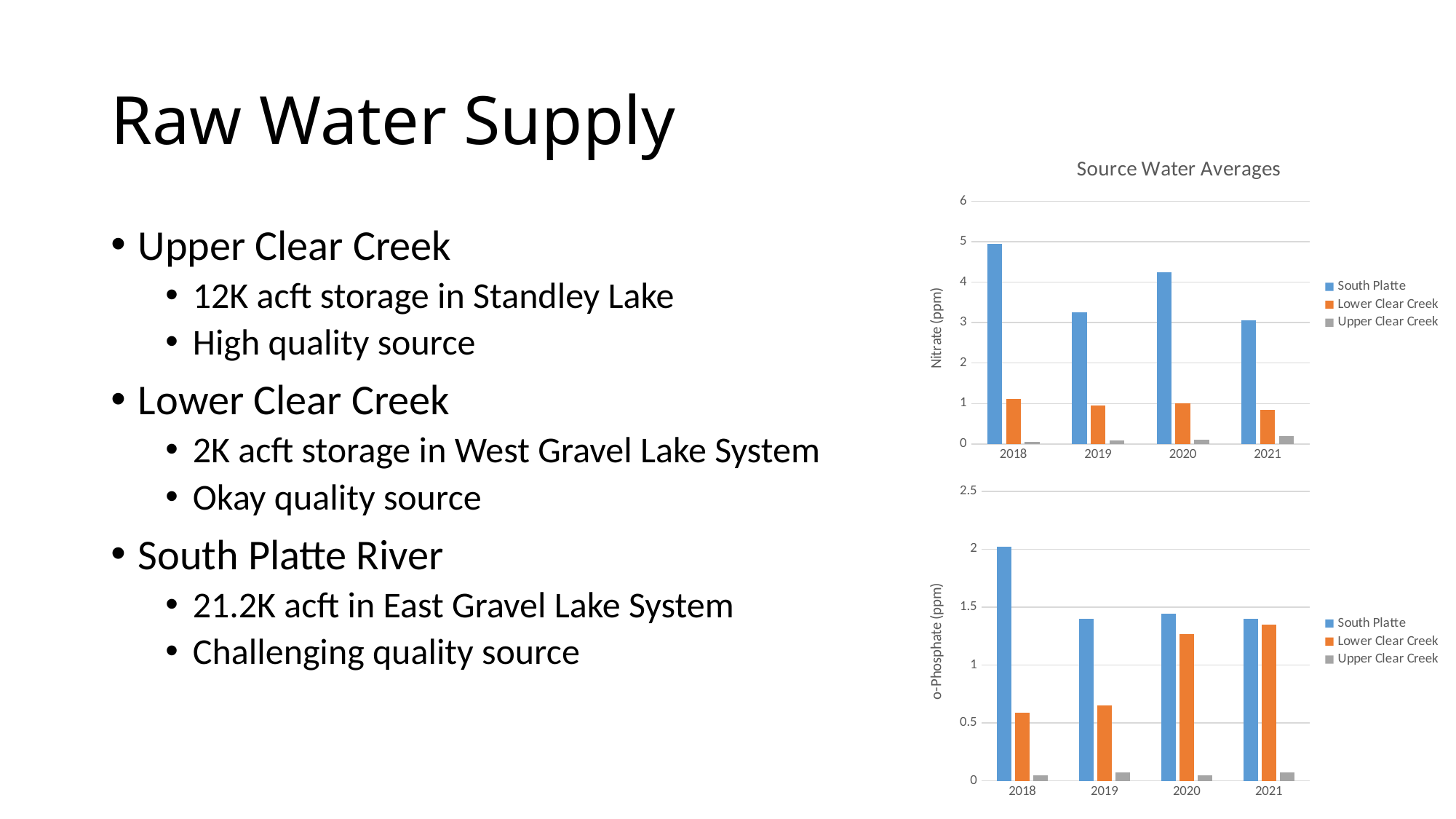
What kind of chart is the top chart titled 'Source Water Averages'? bar chart How many series does the legend of the top chart (Nitrate) list? 3 In the top chart (Nitrate), in which year is the South Platte value highest? 2018 In the bottom chart (o-Phosphate), is the South Platte value for 2018 greater or less than 1.5? greater In the top chart (Nitrate), which is larger for 2019: South Platte or Lower Clear Creek? South Platte In the top chart (Nitrate), which series has the lowest value in 2021? Upper Clear Creek How many years are shown on the x axis of the top chart (Nitrate)? 4 In the top chart (Nitrate), is the South Platte value for 2021 greater or less than 4? less What is the y-axis label of the bottom chart? o-Phosphate (ppm) In the bottom chart (o-Phosphate), is the Lower Clear Creek value for 2018 greater or less than 1? less In the bottom chart (o-Phosphate), in which year is the South Platte value highest? 2018